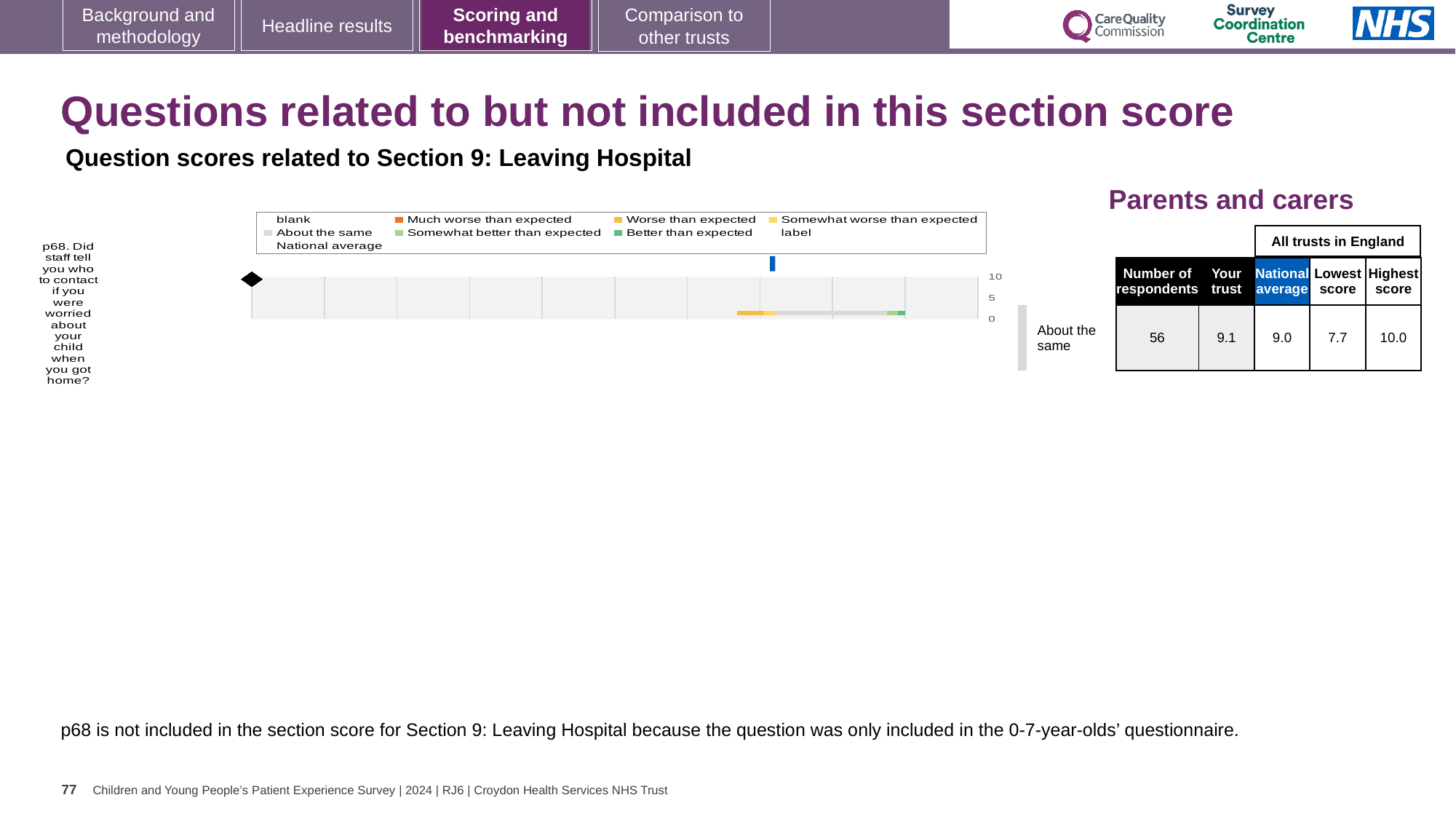
Is the 'Your trust' score for question p68 greater or less than 5 on the chart axis? greater What is the highest value shown on the chart's score axis? 10 What rating label is shown next to the bar for question p68? About the same How many questions are plotted in the chart on this slide? 1 What is the national average score for question p68? 9.0 What is the highest score among all trusts in England for question p68? 10.0 What is the difference between the highest score and the lowest score for question p68? 2.3 What is the 'Your trust' score for question p68? 9.1 How many respondents answered question p68? 56 What is the lowest score among all trusts in England for question p68? 7.7 What kind of chart is shown on the slide for question p68? bar chart How many entries does the chart legend list? 9